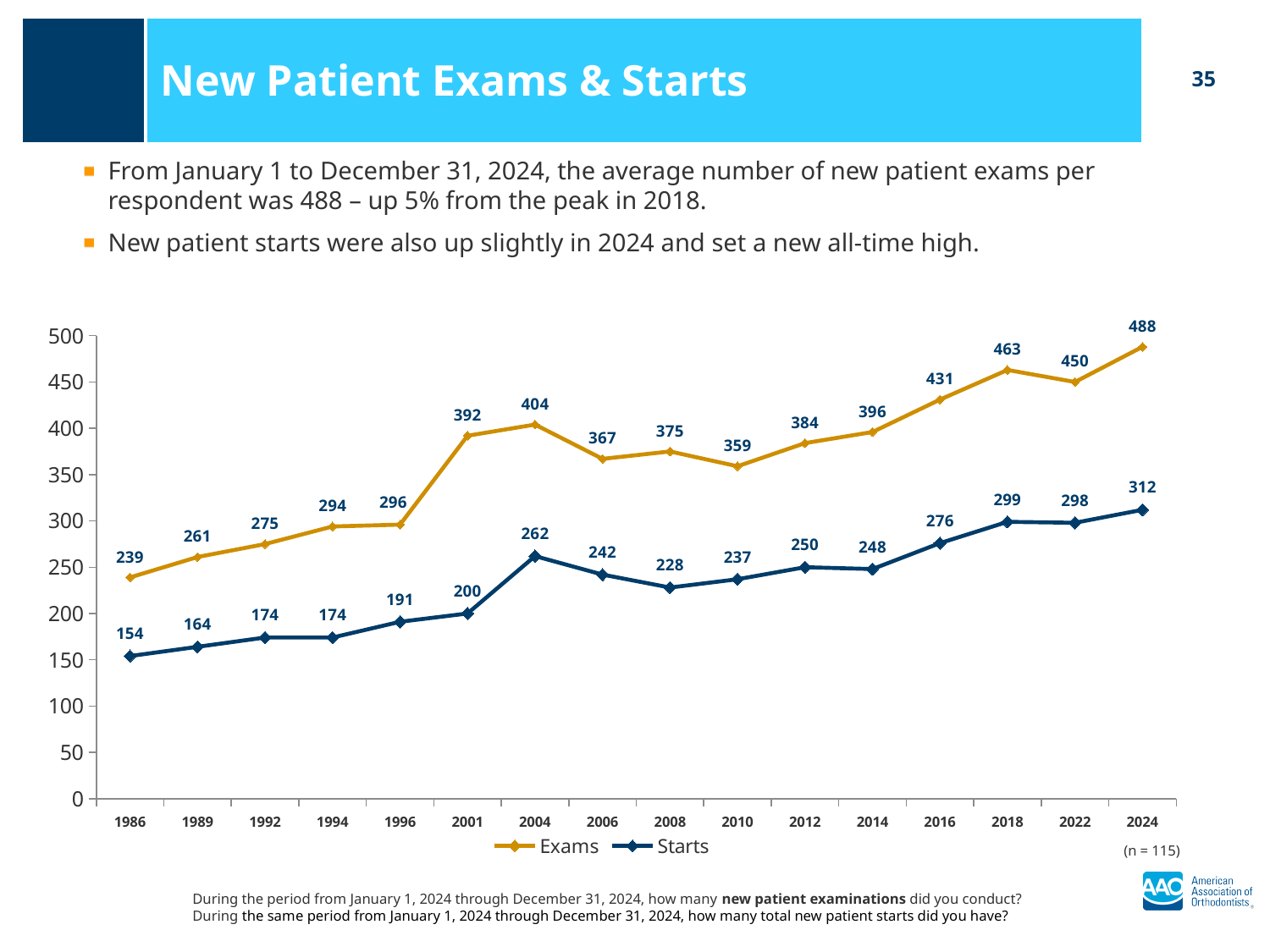
Do the Starts values rise or fall from 2016 to 2024? Rise How many series does the legend list? 2 How many years are shown on the x axis? 16 In which year is the Starts series lowest? 1986 Which is larger, Exams in 2018 or Exams in 2022? Exams in 2018 What is the value for Exams in 2024? 488 What is the difference between Exams and Starts in 2024? 176 What kind of chart is shown on the slide? Line chart In which year is the Exams series highest? 2024 What colour is the Exams line? Gold What is the value for Starts in 2004? 262 What is the value for Exams in 1986? 239